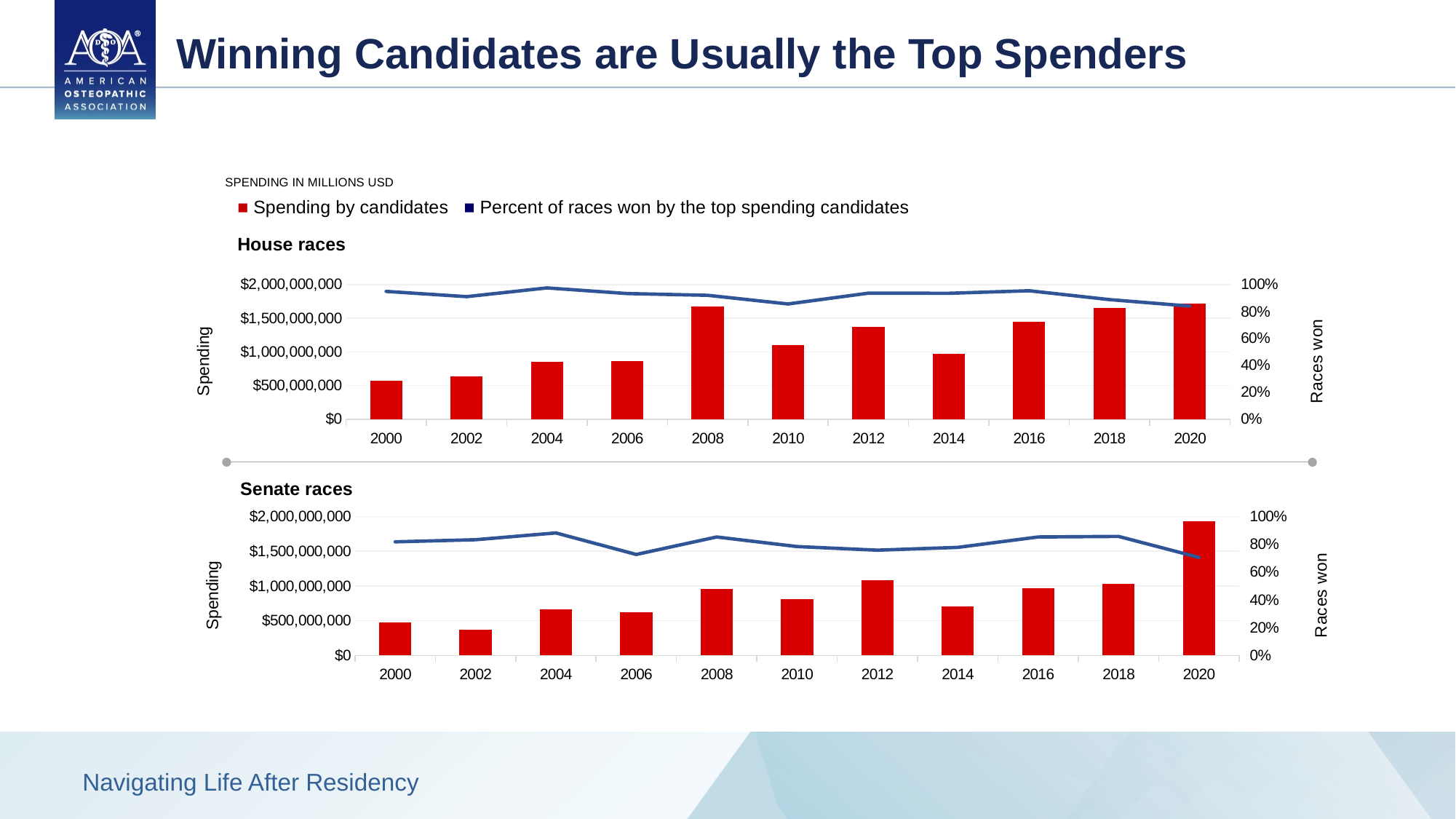
In the House races chart, which year has higher spending by candidates, 2010 or 2012? 2012 In the Senate races chart, what kind of chart is used to show spending by candidates? Bar chart In the Senate races chart, which year has the lowest spending by candidates? 2002 In the House races chart, which year has the lowest spending by candidates? 2000 In the Senate races chart, which year has the lowest percent of races won by the top spending candidates? 2020 In the Senate races chart, which year has the highest spending by candidates? 2020 In the House races chart, how many years are shown on the x axis? 11 In the Senate races chart, is spending by candidates in 2020 greater or less than $1,500,000,000? greater What is the second entry in the legend? Percent of races won by the top spending candidates How many series does the legend list? 2 In the House races chart, is spending by candidates in 2008 greater or less than $1,500,000,000? greater